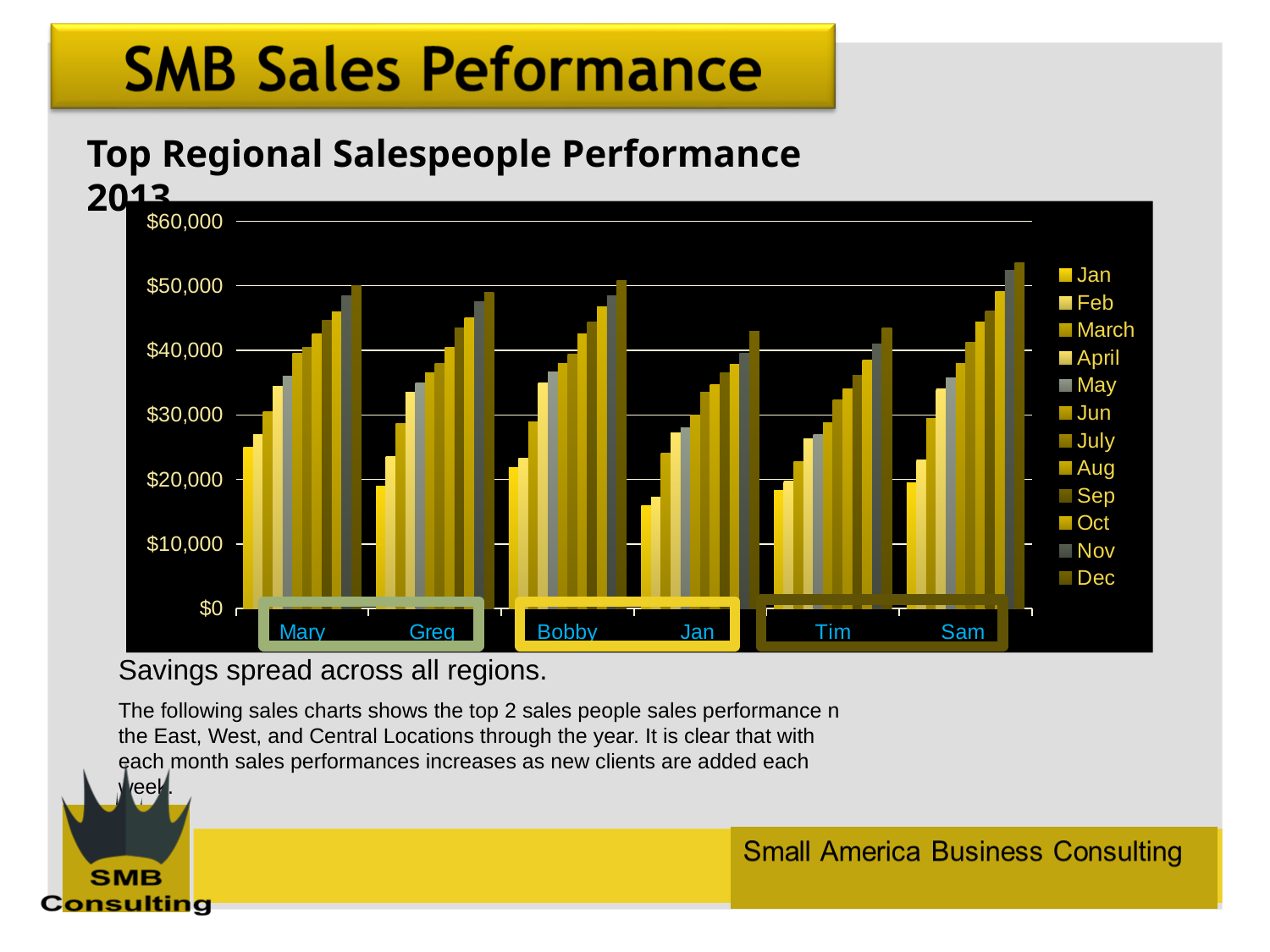
How many series does the chart's legend list? 12 Is the Jan value for Jan greater or less than $20,000? less Which is larger, the Jan value for Mary or the Jan value for Jan? Mary Is the Dec value for Tim greater or less than $50,000? less For each salesperson, do the monthly values rise or fall from Jan to Dec? rise Is the Jan value for Mary greater or less than $20,000? greater What kind of chart is shown on the slide? bar chart How many salespeople are shown on the x axis of the chart? 6 What is the title of the chart? Top Regional Salespeople Performance 2013 Which is larger, the Dec value for Mary or the Dec value for Tim? Mary